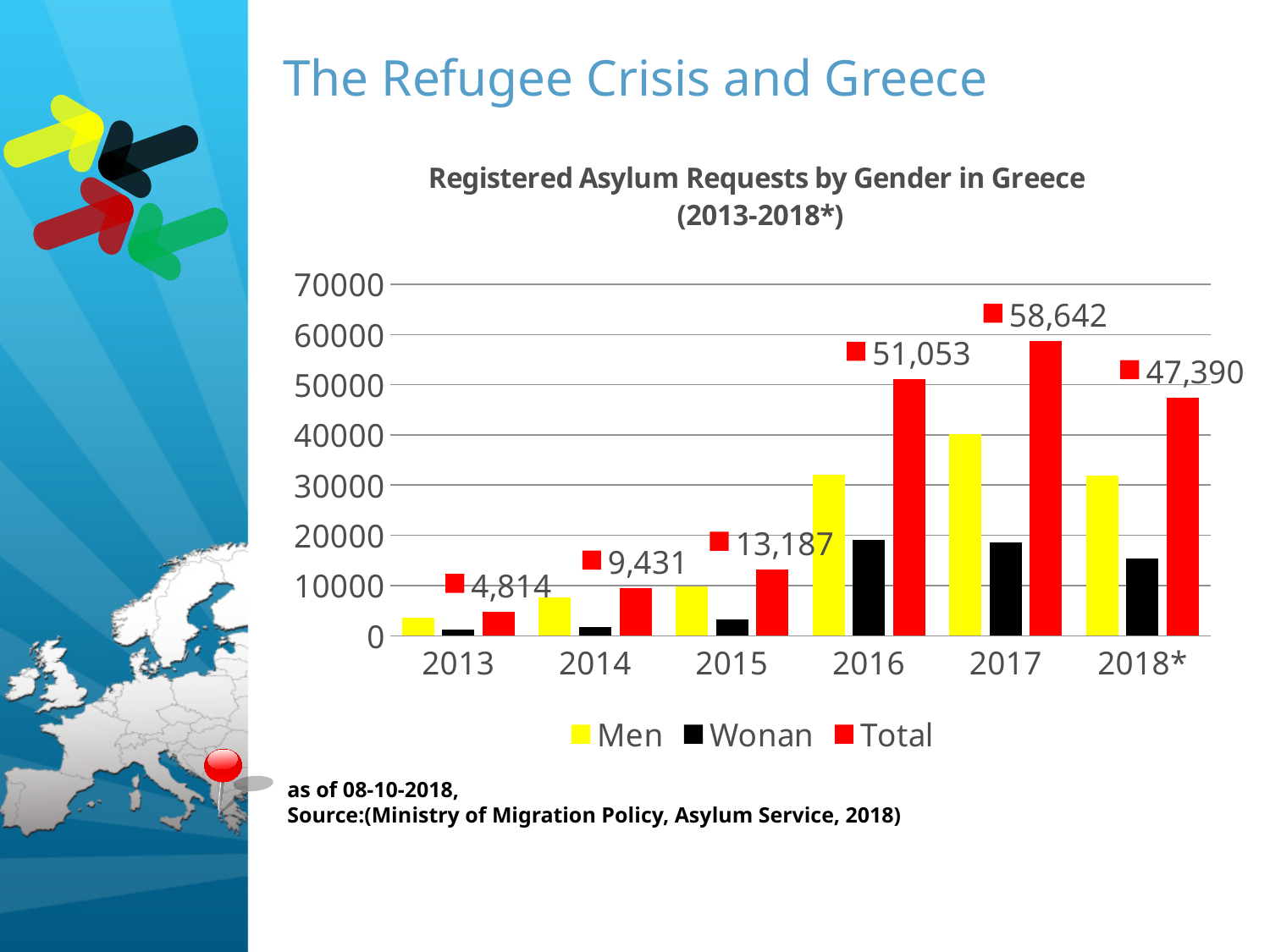
What is the Total value for 2017? 58,642 Do the Total values rise or fall from 2013 to 2017? rise Is the value for Men in 2017 greater or less than 30000? greater Which year has the highest Total value? 2017 How many series does the legend list? 3 What is the Total value for 2013? 4,814 What is the difference between the Total values for 2017 and 2016? 7,589 What kind of chart is shown on the slide? bar chart Which year has the larger Total value, 2016 or 2018*? 2016 Is the value for Wonan in 2016 greater or less than 10000? greater Which year has the lowest Total value? 2013 How many years are shown on the x axis? 6